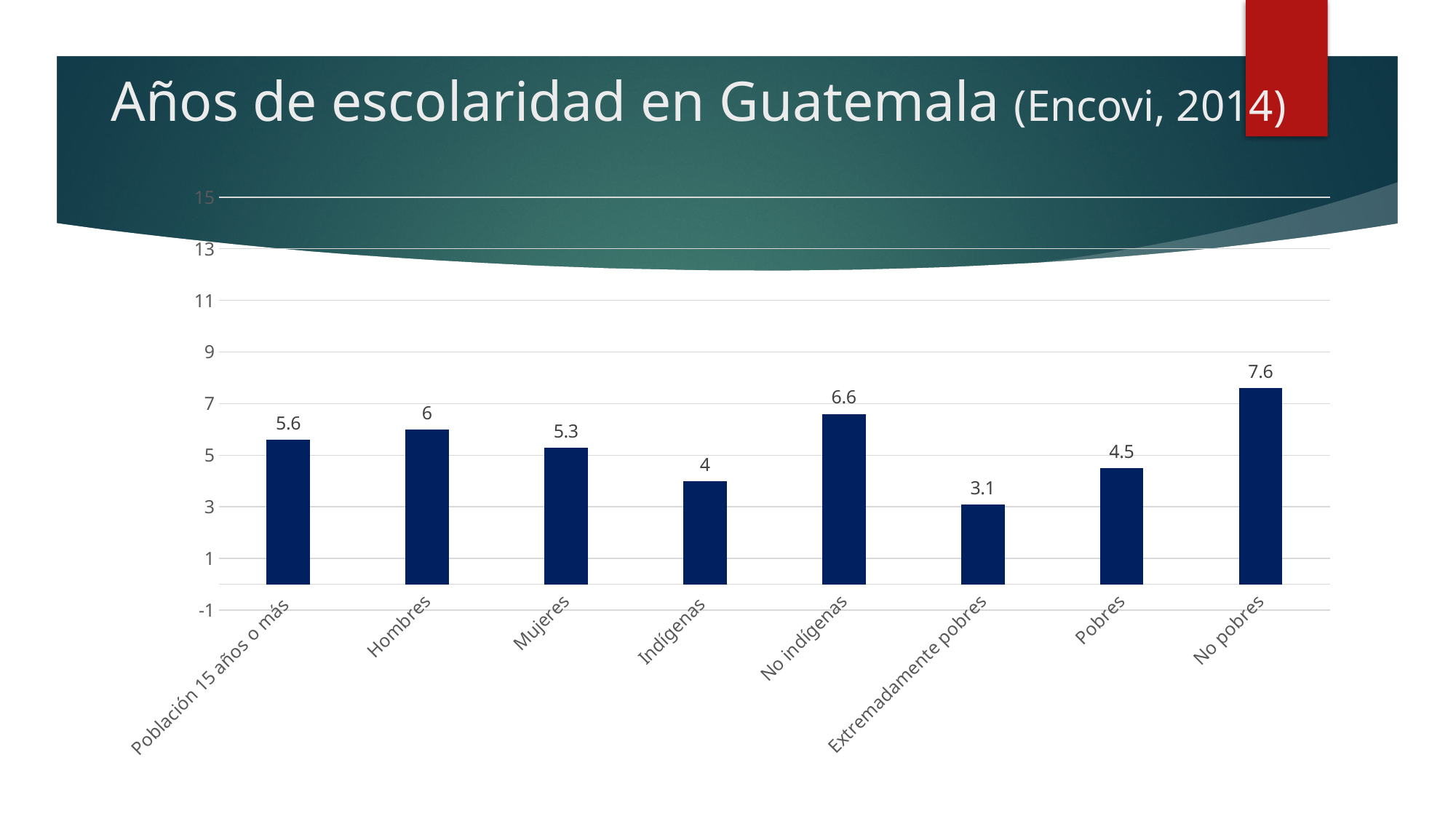
What is the value for Indígenas? 4 What is the value for Población 15 años o más? 5.6 What is the value for Hombres? 6 What is the difference between the values for No indígenas and Indígenas? 2.6 What kind of chart is shown on the slide? bar chart Which is larger, the value for Pobres or the value for No pobres? No pobres How many categories are shown on the x axis? 8 What is the value for Extremadamente pobres? 3.1 Is the value for No indígenas greater or less than 5? greater Which category has the lowest value? Extremadamente pobres What is the difference between the values for Hombres and Mujeres? 0.7 Which category has the highest value? No pobres